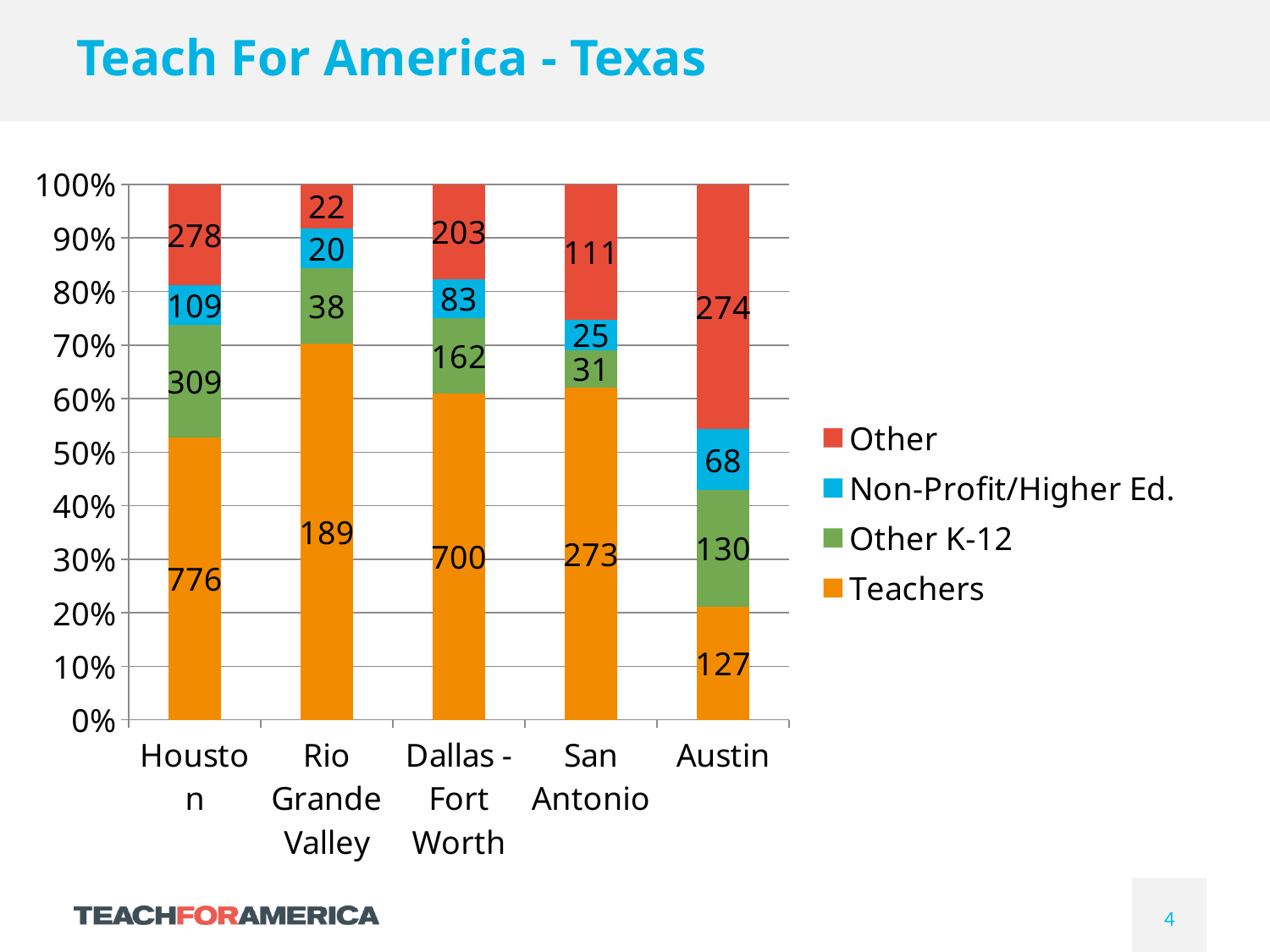
What is the value for Other K-12 in Dallas - Fort Worth? 162 How many series does the legend list? 4 Which city has the lowest value for Other? Rio Grande Valley What kind of chart is shown on the slide? Stacked bar chart What is the value for Teachers in Houston? 776 Which city has the highest value for Teachers? Houston What is the difference between the Other value for Houston and the Other value for Austin? 4 Is the Teachers share of the Austin bar greater or less than 30%? less How many cities are shown on the x axis? 5 What is the total of all four segments in the Rio Grande Valley bar? 269 What is the value for Non-Profit/Higher Ed. in Austin? 68 Which is larger: the Teachers value for Dallas - Fort Worth or the Teachers value for San Antonio? Dallas - Fort Worth